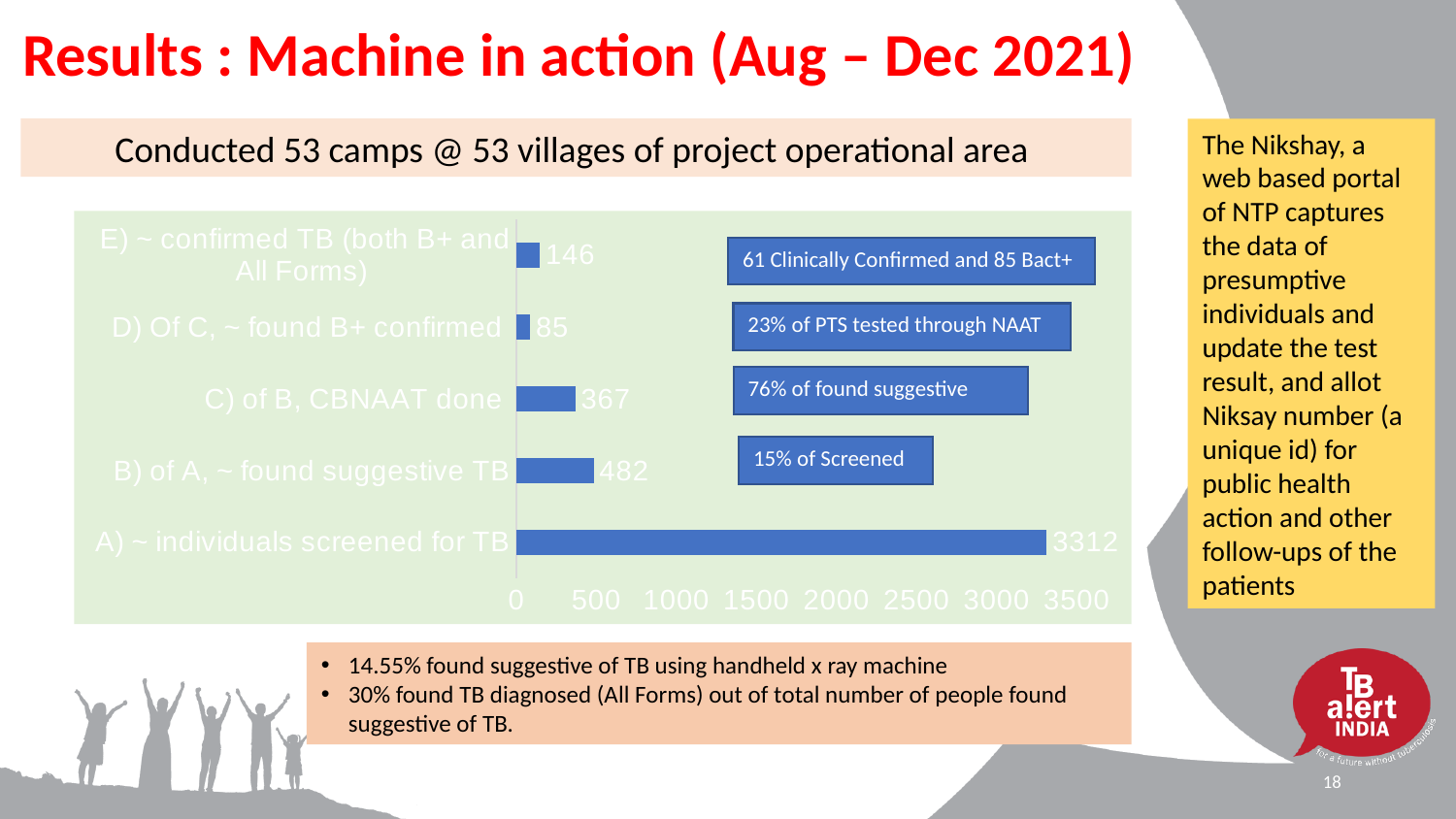
Which is larger: the value for 'E) ~ confirmed TB (both B+ and All Forms)' or the value for 'D) Of C, ~ found B+ confirmed'? E) ~ confirmed TB (both B+ and All Forms) Is the value for 'A) ~ individuals screened for TB' greater or less than 3000? greater What value is shown for 'E) ~ confirmed TB (both B+ and All Forms)'? 146 What value is shown for 'A) ~ individuals screened for TB'? 3312 What value is shown for 'D) Of C, ~ found B+ confirmed'? 85 What value is shown for 'B) of A, ~ found suggestive TB'? 482 Which category has the highest value in the chart? A) ~ individuals screened for TB What value is shown for 'C) of B, CBNAAT done'? 367 What is the difference between the values for 'B) of A, ~ found suggestive TB' and 'C) of B, CBNAAT done'? 115 How many categories are shown in the chart? 5 Which category has the lowest value in the chart? D) Of C, ~ found B+ confirmed What kind of chart is shown on the slide? Bar chart